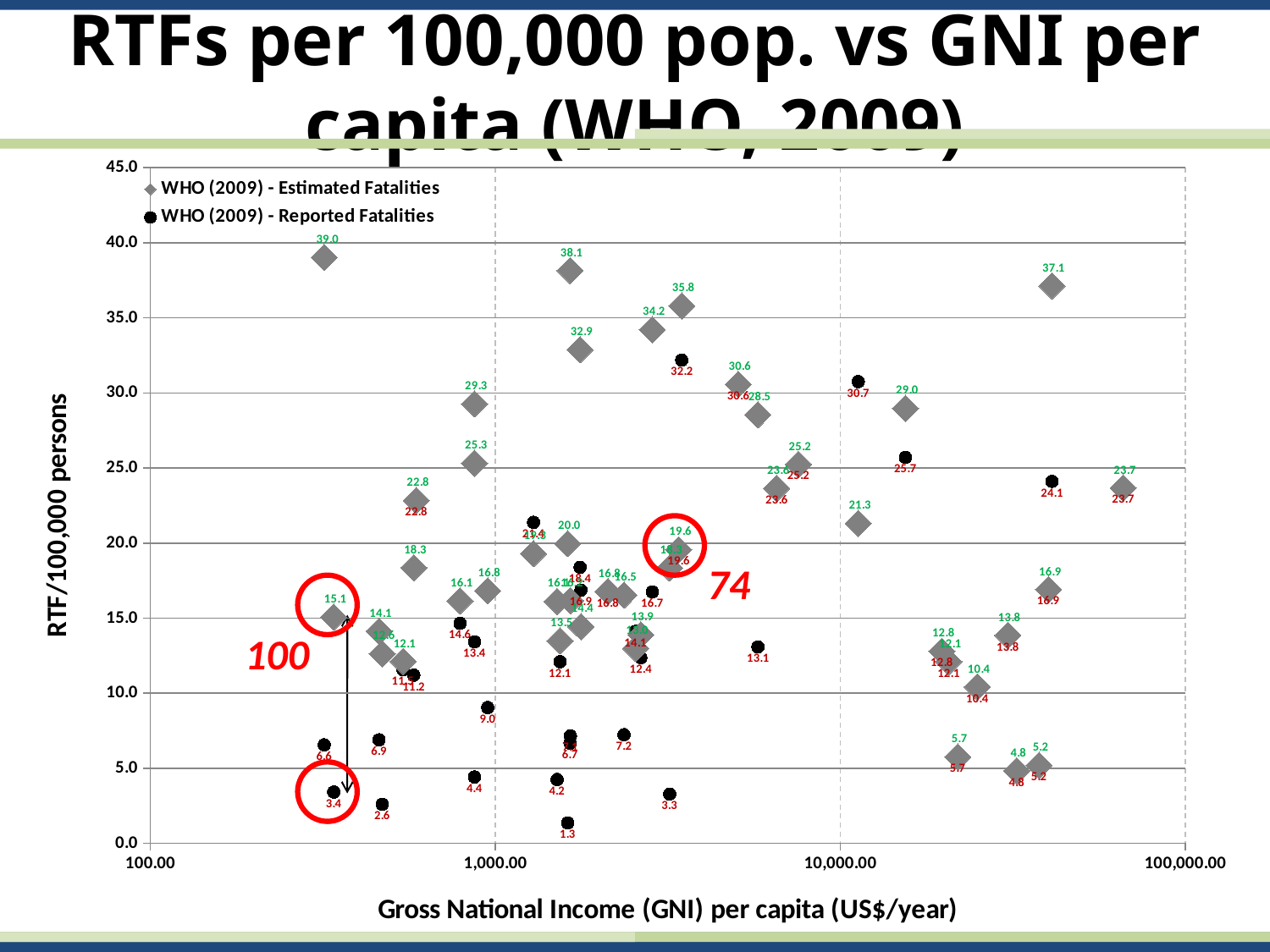
What is the lowest labelled value in the WHO (2009) - Estimated Fatalities series? 4.8 What is the title of the y axis? RTF/100,000 persons What are the two series named in the legend? WHO (2009) - Estimated Fatalities and WHO (2009) - Reported Fatalities Which is larger: the highest Estimated Fatalities value or the highest Reported Fatalities value? The highest Estimated Fatalities value What is the difference between the highest Estimated Fatalities value (39.0) and the highest Reported Fatalities value (32.2)? 6.8 Is the Estimated Fatalities point labelled 37.1 greater or less than 35.0 on the y axis? greater What kind of chart is shown on the slide? Scatter chart What is the highest labelled value in the WHO (2009) - Estimated Fatalities series? 39.0 What is the lowest labelled value in the WHO (2009) - Reported Fatalities series? 1.3 What is the maximum value shown on the y axis? 45.0 What is the highest labelled value in the WHO (2009) - Reported Fatalities series? 32.2 How many series does the legend list? 2